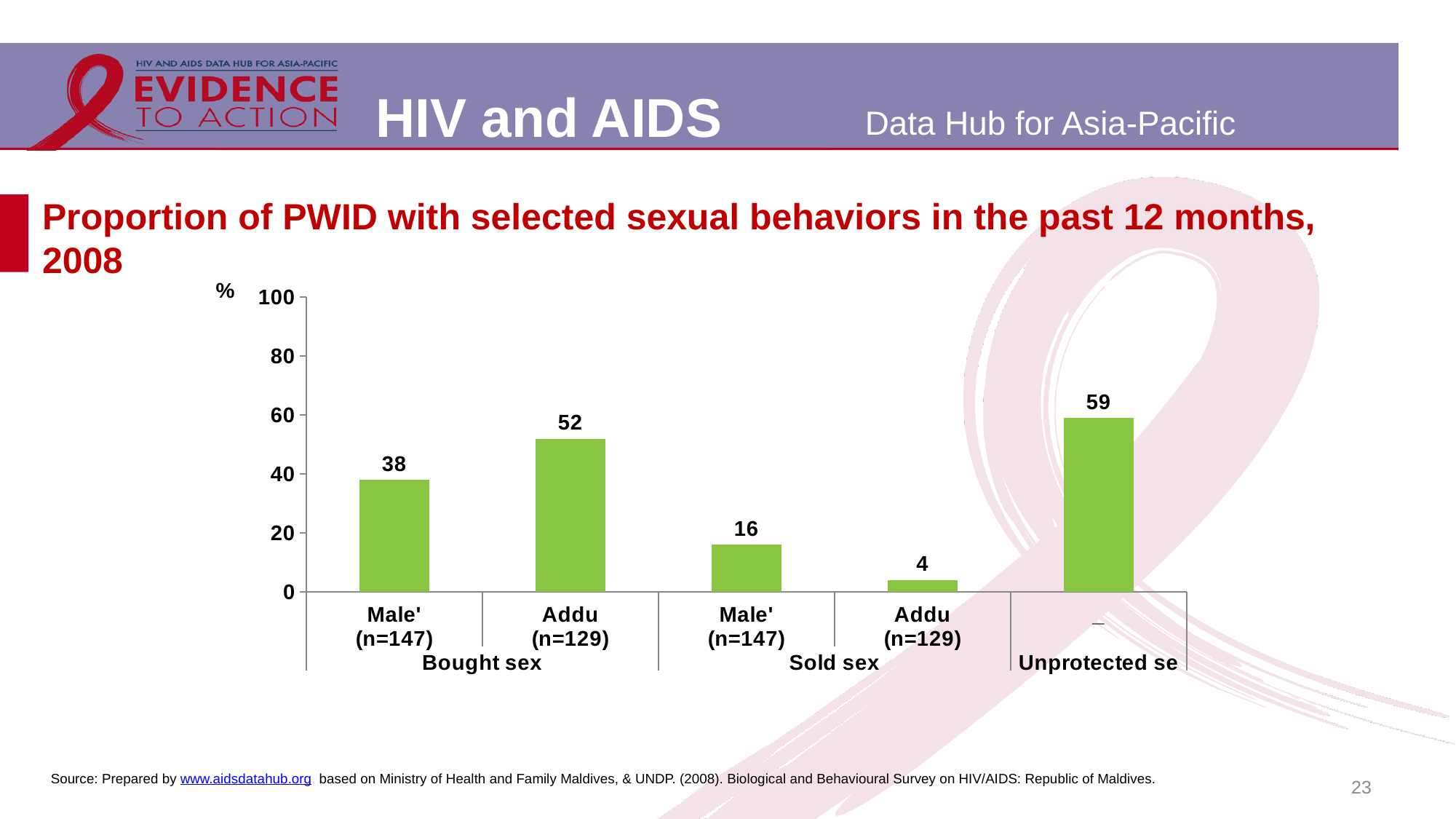
What is the value for Male' (n=147) under Bought sex? 38 What is the value for Addu (n=129) under Bought sex? 52 What is the difference between the Addu and Male' values under Bought sex? 14 What is the maximum value shown on the vertical axis? 100 How many bars are plotted on the chart? 5 Under Bought sex, which is larger: the value for Male' or the value for Addu? Addu What is the difference between the Male' and Addu values under Sold sex? 12 What is the value for Male' (n=147) under Sold sex? 16 What is the highest value plotted on the chart? 59 Which bar has the lowest value on the chart? Addu (n=129), Sold sex What is the value for Addu (n=129) under Sold sex? 4 What kind of chart is shown on the slide? Bar chart